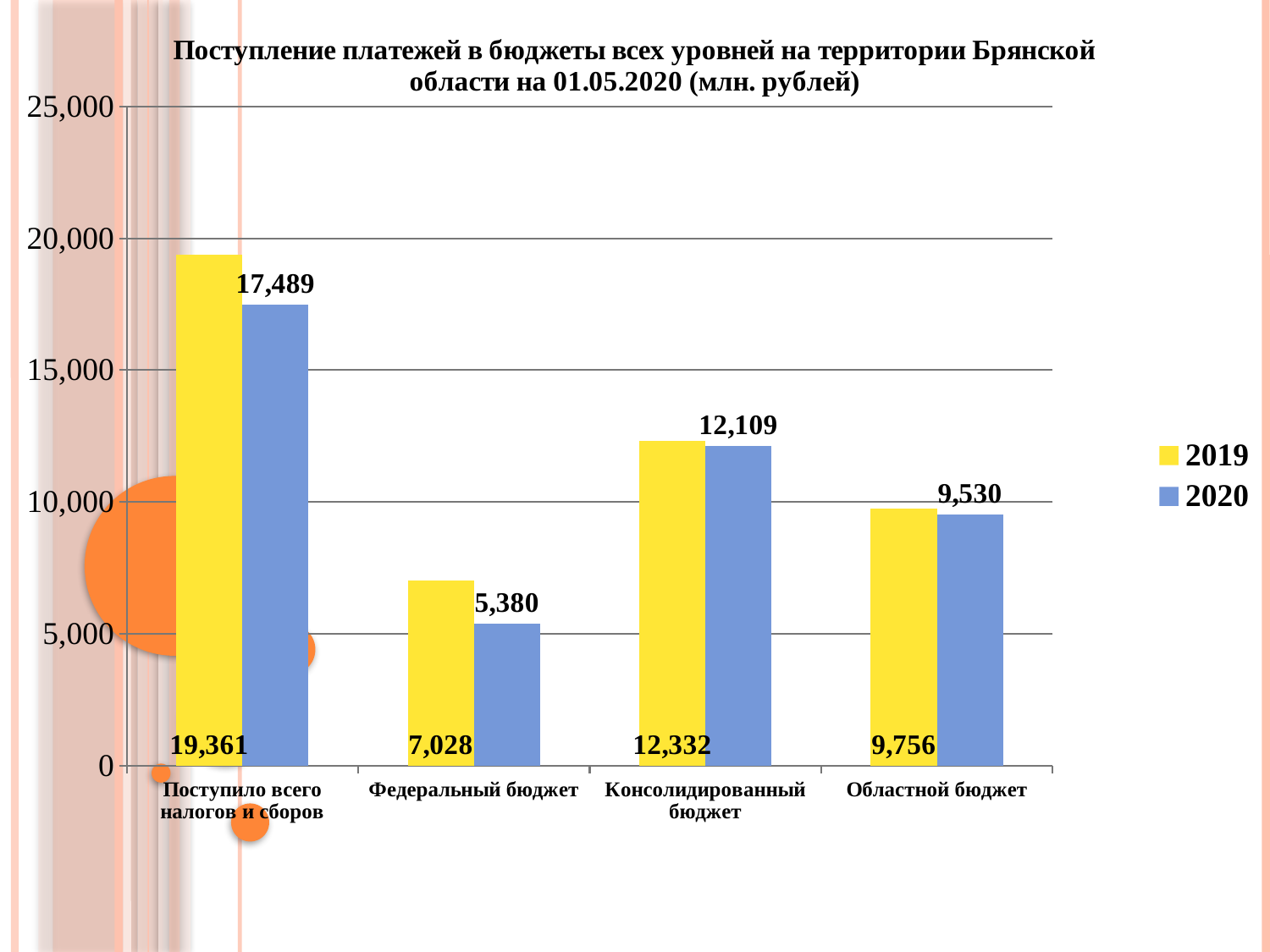
What is the 2020 value for "Консолидированный бюджет"? 12,109 What is the 2019 value for "Областной бюджет"? 9,756 How many categories are shown on the x axis? 4 What is the difference between the 2019 and 2020 values for "Поступило всего налогов и сборов"? 1,872 Which is larger for "Федеральный бюджет": the 2019 value or the 2020 value? 2019 Which category has the highest 2019 value? Поступило всего налогов и сборов What kind of chart is shown on the slide? bar chart What is the 2019 value for "Поступило всего налогов и сборов"? 19,361 Which series is shown in yellow in the legend? 2019 Which category has the lowest 2020 value? Федеральный бюджет How many series does the legend list? 2 What is the 2020 value for "Федеральный бюджет"? 5,380